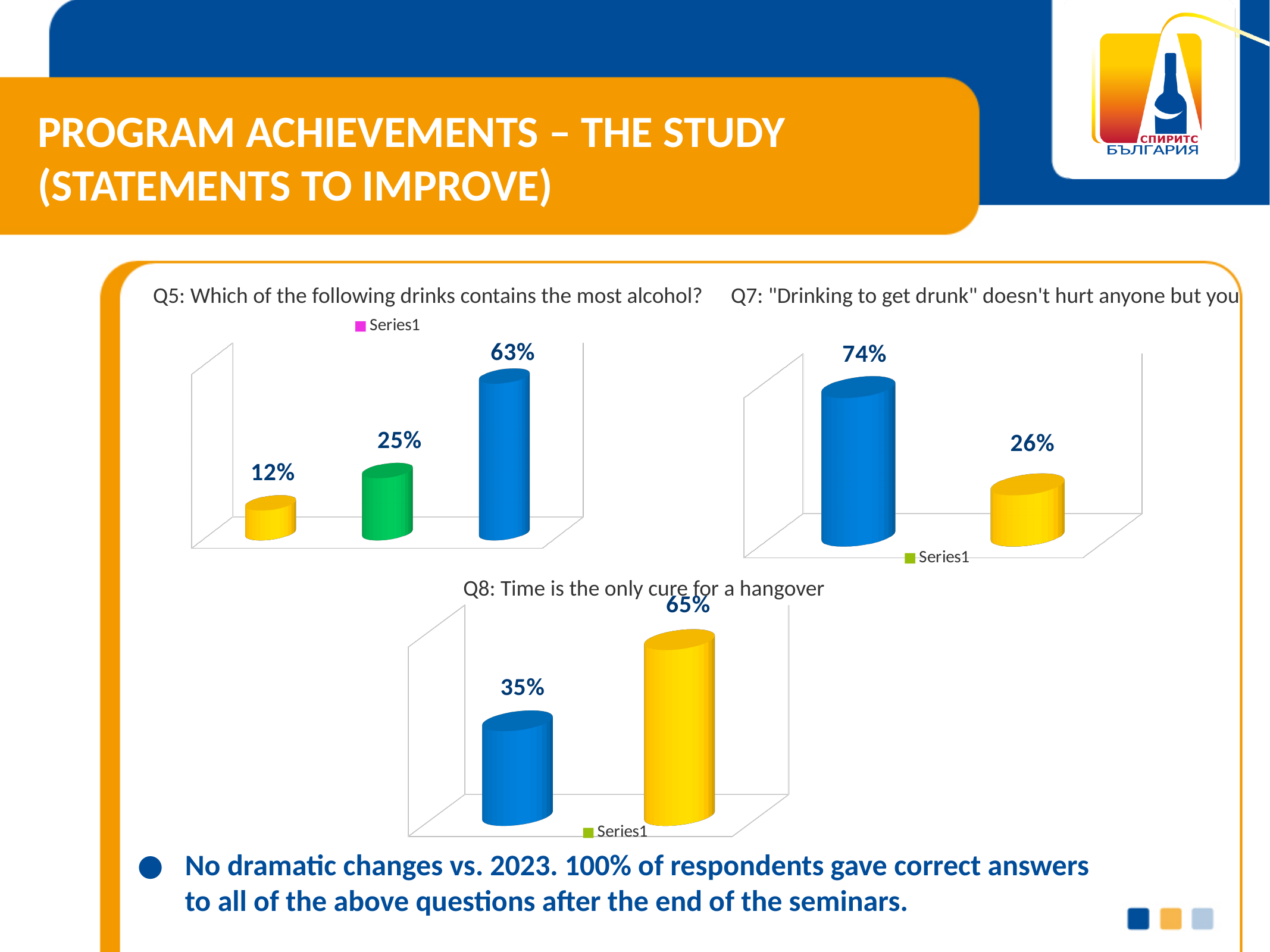
In the chart titled "Q7: 'Drinking to get drunk' doesn't hurt anyone but you", what value is labelled on the yellow bar? 26% What kind of chart is the one titled "Q8: Time is the only cure for a hangover"? bar chart In the chart titled "Q5: Which of the following drinks contains the most alcohol?", how many bars are plotted? 3 In the chart titled "Q5: Which of the following drinks contains the most alcohol?", what is the difference between the highest and lowest bar values? 51% In the chart titled "Q8: Time is the only cure for a hangover", what is the total of the two bar values? 100% In the chart titled "Q8: Time is the only cure for a hangover", what value is labelled on the blue bar? 35% In the chart titled "Q5: Which of the following drinks contains the most alcohol?", what is the value shown on the shortest bar? 12% In the chart titled "Q7: 'Drinking to get drunk' doesn't hurt anyone but you", what is the difference between the two bar values? 48% In the chart titled "Q5: Which of the following drinks contains the most alcohol?", what value is labelled on the middle (green) bar? 25% In the chart titled "Q7: 'Drinking to get drunk' doesn't hurt anyone but you", what value is labelled on the blue bar? 74% In the chart titled "Q5: Which of the following drinks contains the most alcohol?", what is the value shown on the tallest bar? 63% In the chart titled "Q8: Time is the only cure for a hangover", which bar is taller, the blue one or the yellow one? the yellow one